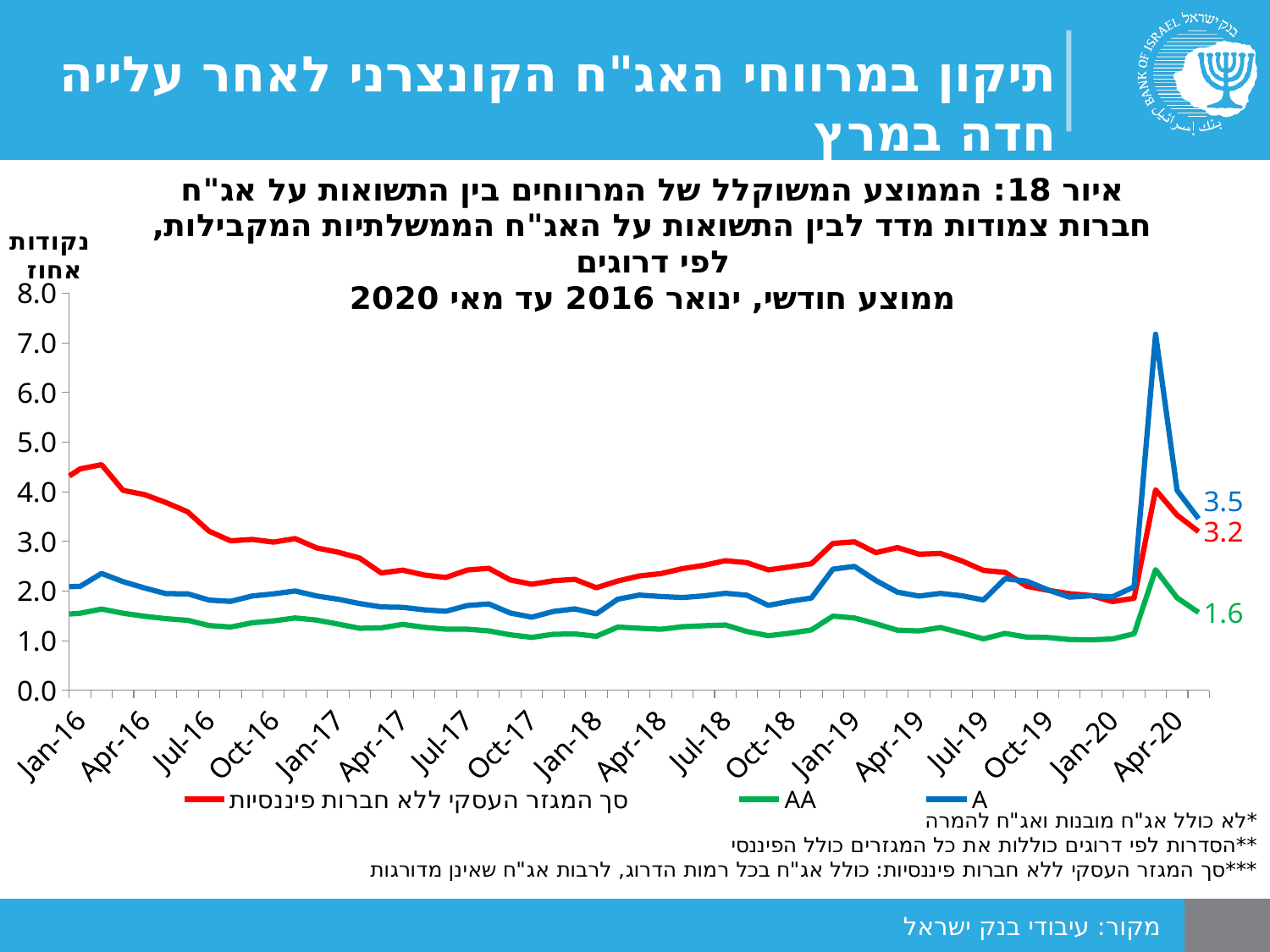
What is the final labelled value of the A series? 3.5 What is the final labelled value of the series סך המגזר העסקי ללא חברות פיננסיות? 3.2 Which series has the highest labelled value at the end of the chart? A Does the series סך המגזר העסקי ללא חברות פיננסיות rise or fall between Jan-16 and Jan-17? fall What is the difference between the final labelled values of the A series and the AA series? 1.9 Is the value of the AA series at Jan-16 greater or less than 2.0? less How many series does the legend list? 3 Is the value of the A series at its peak around Apr-20 greater or less than 6.0? greater What is the label on the vertical axis of the chart? נקודות אחוז What is the final labelled value of the AA series? 1.6 Which series has the lowest labelled value at the end of the chart? AA What kind of chart is shown on the slide? line chart